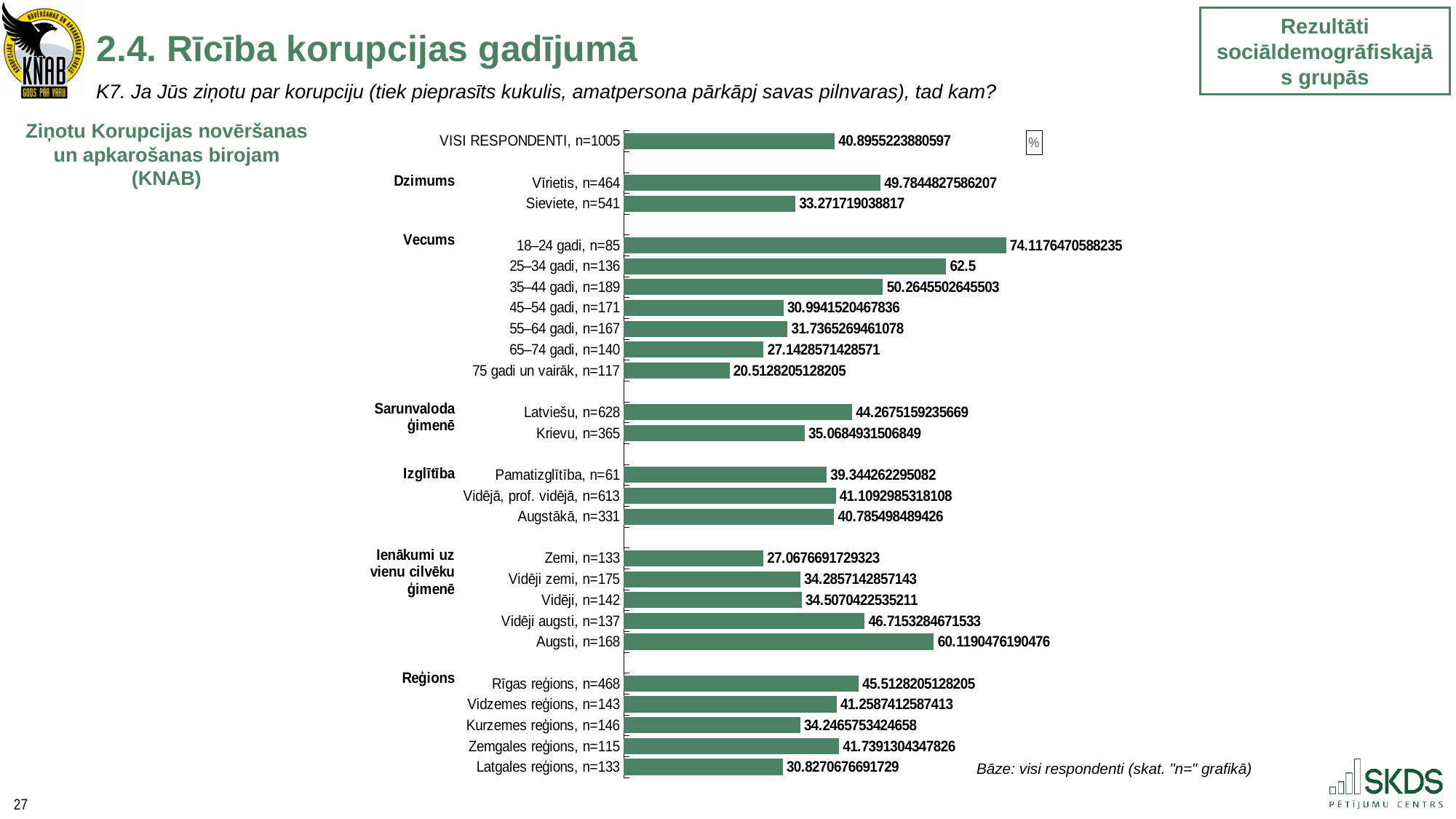
What is the difference between the values for 25–34 gadi, n=136 and 35–44 gadi, n=189? 12.2354497354497 What is the title of the chart on the left side of the slide? Ziņotu Korupcijas novēršanas un apkarošanas birojam (KNAB) What value is shown for 25–34 gadi, n=136? 62.5 Which has a larger value, Rīgas reģions, n=468 or Latgales reģions, n=133? Rīgas reģions, n=468 What value is shown for Latgales reģions, n=133? 30.8270676691729 What value is shown for Vīrietis, n=464? 49.7844827586207 What kind of chart is shown on the slide? Bar chart Which category has the lowest value? 75 gadi un vairāk, n=117 Which category has the highest value? 18–24 gadi, n=85 How many bars are plotted in the chart? 25 What value is shown for VISI RESPONDENTI, n=1005? 40.8955223880597 What value is shown for Augsti, n=168? 60.1190476190476